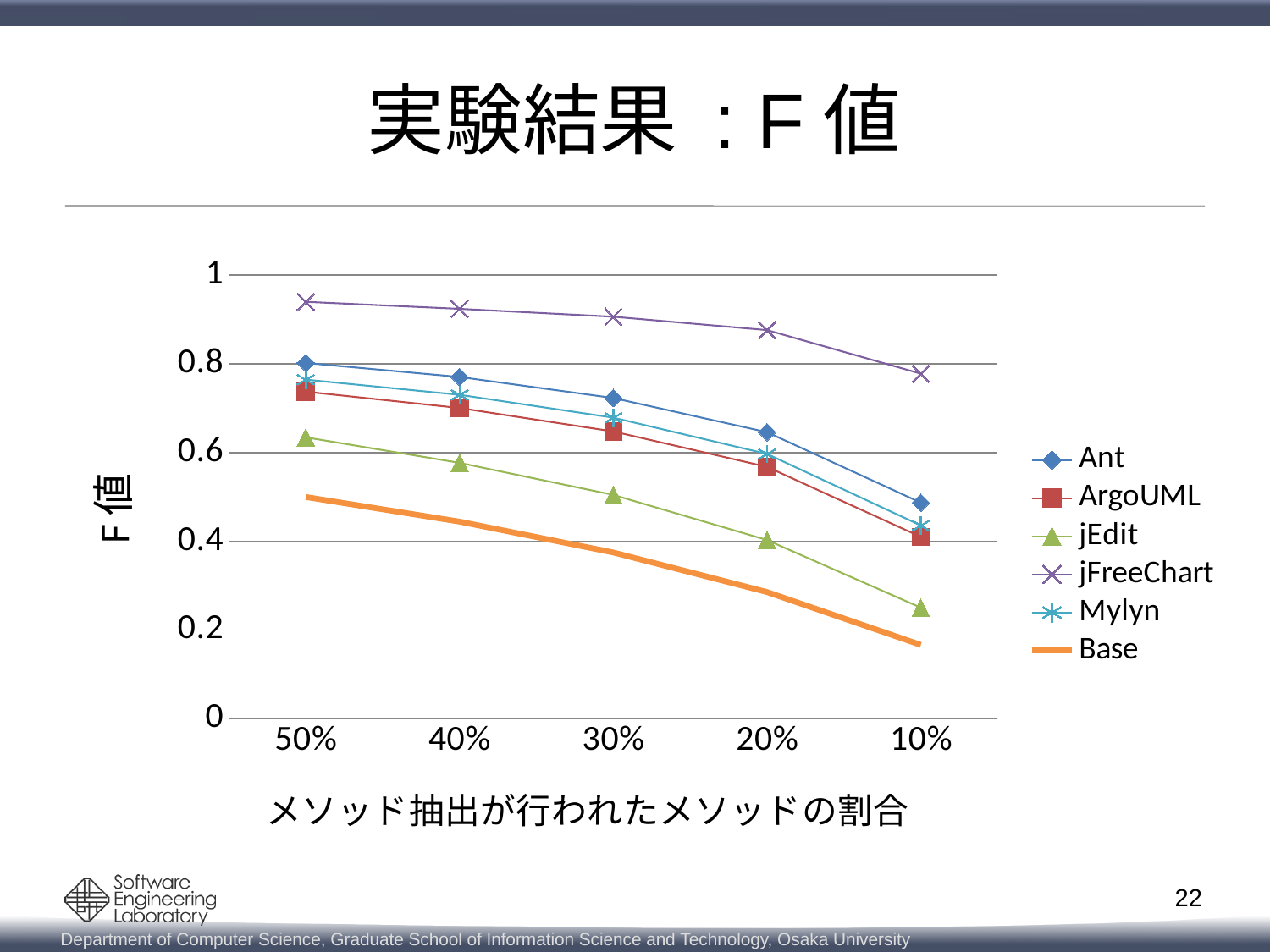
Is the value for jFreeChart at 10% greater or less than 0.6? greater Do the values of the Ant series rise or fall moving from 50% to 10% along the x axis? fall What kind of chart is shown on the slide? line chart Which series has the lowest value at 10%? Base At 30%, which is larger, the value for Ant or the value for jEdit? Ant What is the label of the y axis? F値 Which series has the lowest value at 50%? Base How many categories are shown on the x axis? 5 Which series has the highest value at 50%? jFreeChart Is the value for jEdit at 10% greater or less than 0.4? less Is the value for Base at 50% greater or less than 0.4? greater How many series does the legend list? 6